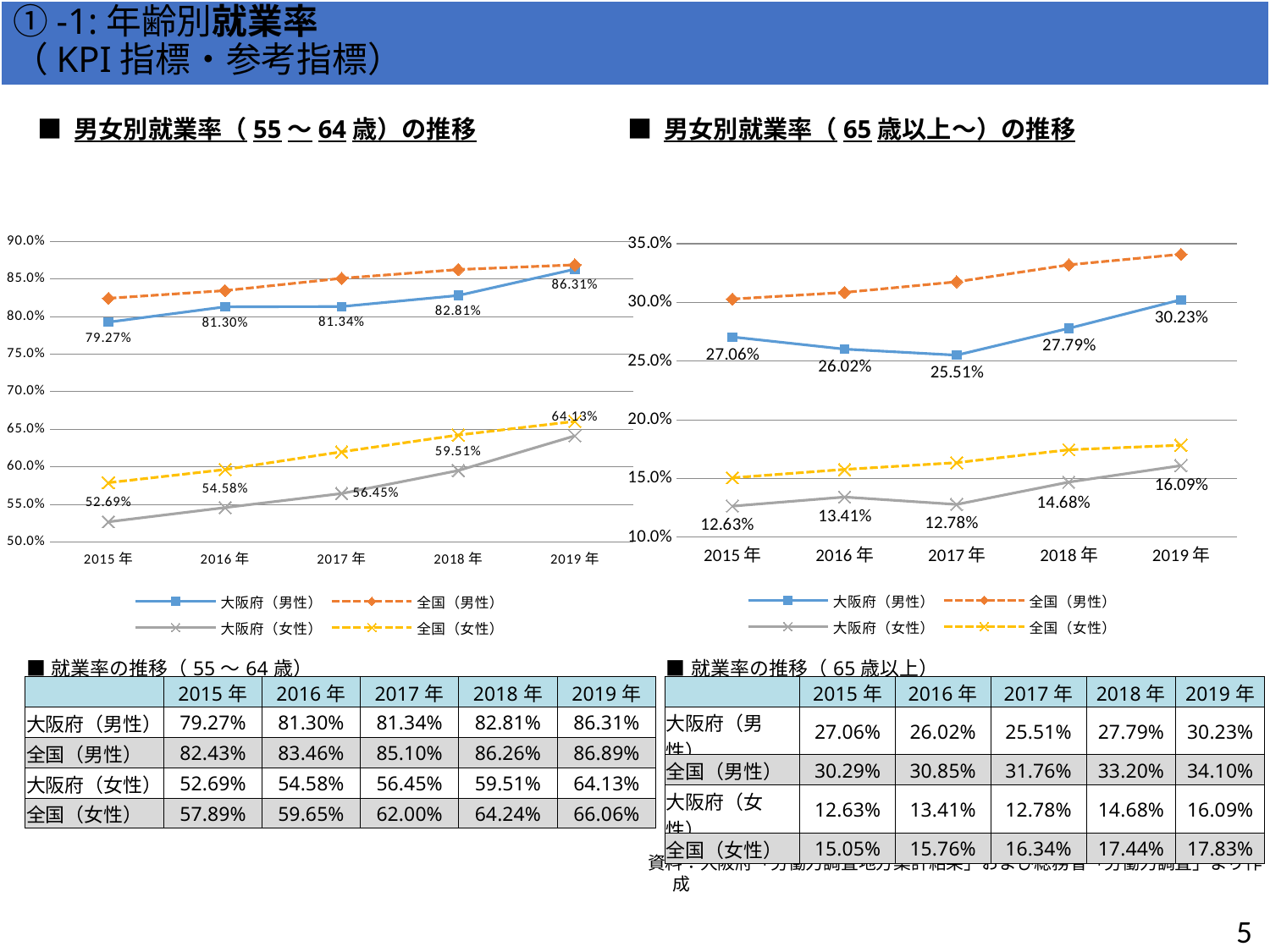
In the left chart (男女別就業率（55～64歳）の推移), does the value for 大阪府（女性） rise or fall from 2015年 to 2019年? rises In the right chart (男女別就業率（65歳以上～）の推移), in which year is the value for 大阪府（男性） highest? 2019年 In the left chart (男女別就業率（55～64歳）の推移), is the value for 全国（女性） in 2015年 greater or less than 60.0%? less How many series does the legend of the right chart (男女別就業率（65歳以上～）の推移) list? 4 What kind of chart is the left chart (男女別就業率（55～64歳）の推移)? line chart How many years are plotted on the x axis of the left chart (男女別就業率（55～64歳）の推移)? 5 In the right chart (男女別就業率（65歳以上～）の推移), in which year is the value for 大阪府（男性） lowest? 2017年 In the left chart (男女別就業率（55～64歳）の推移), what is the value for 大阪府（男性） in 2019年? 86.31% In the left chart (男女別就業率（55～64歳）の推移), by how many percentage points did 大阪府（男性） increase from 2015年 to 2019年? 7.04 percentage points In the right chart (男女別就業率（65歳以上～）の推移), is the value for 全国（女性） in 2019年 greater or less than 20.0%? less In the right chart (男女別就業率（65歳以上～）の推移), which is larger in 2019年: 全国（男性） or 大阪府（男性）? 全国（男性） In the right chart (男女別就業率（65歳以上～）の推移), what is the value for 大阪府（女性） in 2015年? 12.63%